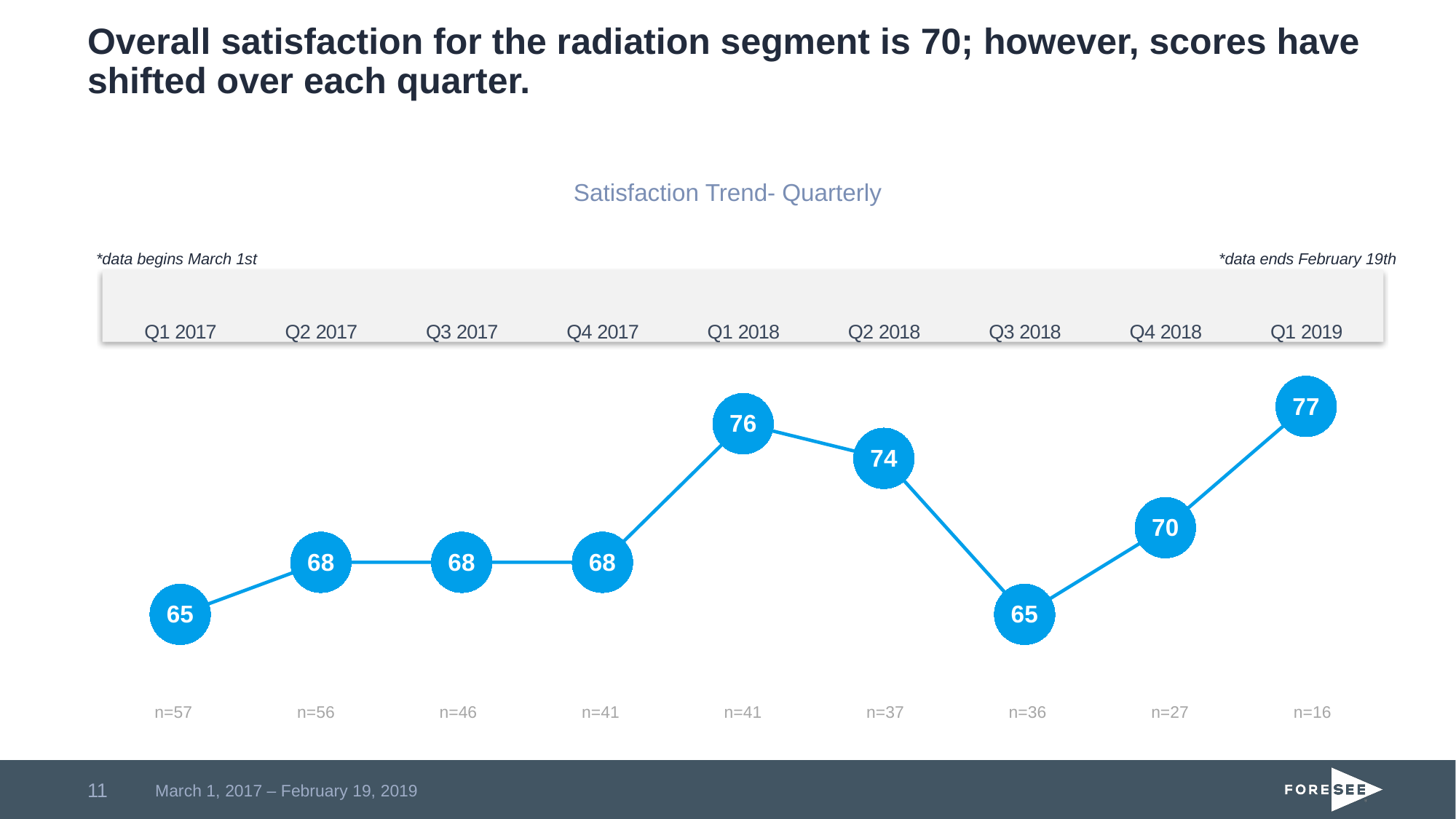
What is the satisfaction score for Q4 2018? 70 Does the satisfaction score rise or fall from Q3 2018 to Q1 2019? Rise What kind of chart is shown on the slide? Line chart What is the difference between the satisfaction scores for Q1 2019 and Q3 2018? 12 Which quarter has the highest satisfaction score? Q1 2019 What is the sample size (n) shown for Q1 2019? n=16 What is the satisfaction score for Q3 2018? 65 Which is larger, the satisfaction score for Q2 2018 or for Q4 2018? Q2 2018 How many quarters are plotted on the chart? 9 What is the title of the chart? Satisfaction Trend- Quarterly What is the difference between the satisfaction scores for Q1 2018 and Q2 2018? 2 What is the satisfaction score for Q1 2018? 76